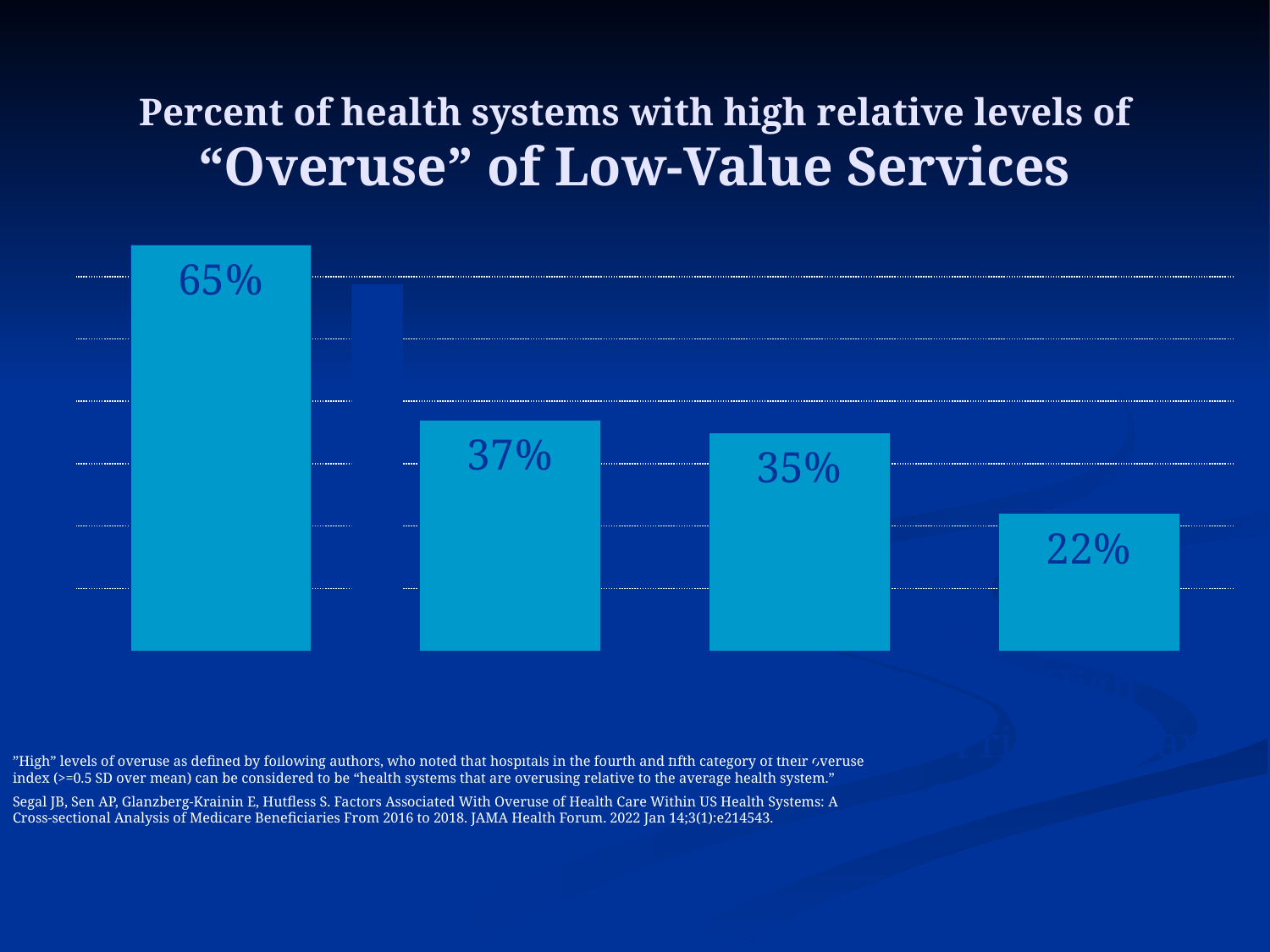
What is the lowest value shown in the chart? 22% What is the value shown on the first (leftmost) bar? 65% What kind of chart is shown on the slide? bar chart What is the title of the chart on the slide? Percent of health systems with high relative levels of "Overuse" of Low-Value Services How many bars are plotted in the chart? 4 What is the value shown on the third bar from the left? 35% What is the highest value shown in the chart? 65% What is the value shown on the fourth (rightmost) bar? 22% Do the bar values rise or fall from left to right across the chart? fall What is the difference between the first bar (65%) and the last bar (22%)? 43% What is the value shown on the second bar from the left? 37% What is the difference between the second bar (37%) and the third bar (35%)? 2%